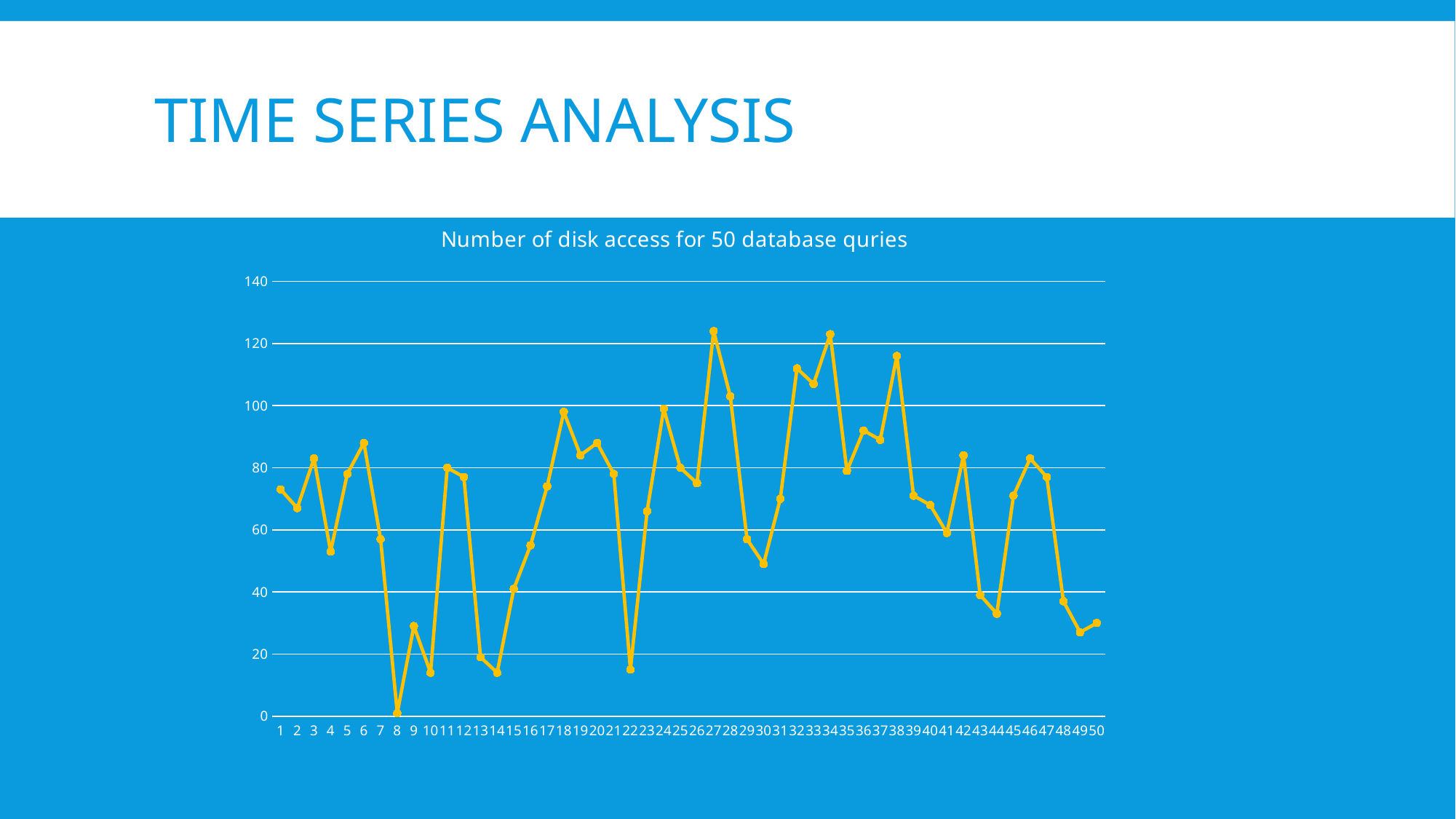
Is the value for query 27 greater or less than 120? greater How many data points are plotted on the chart? 50 What is the title of the chart? Number of disk access for 50 database quries Is the value for query 38 greater or less than 100? greater Is the value for query 22 greater or less than 20? less Which has a larger value, query 18 or query 14? query 18 From query 38 to query 41, do the values rise or fall? fall Which query number has the lowest number of disk accesses? 8 What kind of chart is shown on the slide? line chart Which has a larger value, query 34 or query 49? query 34